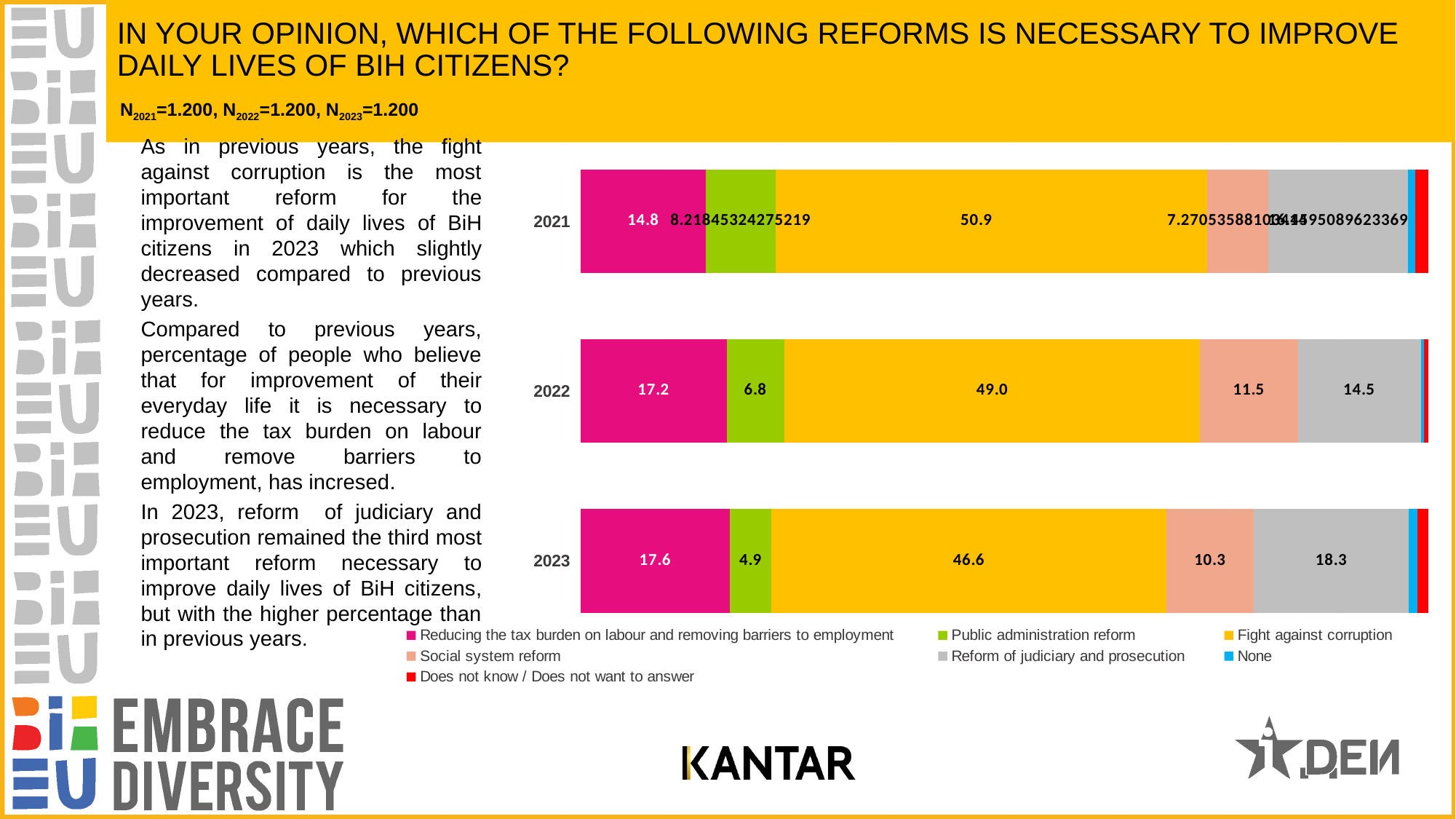
How many years are shown on the chart? 3 Does the value for Fight against corruption rise or fall from 2021 to 2023? fall In which year is the value for Fight against corruption highest? 2021 What is the value for Reform of judiciary and prosecution in 2023? 18.3 In which year is the value for Public administration reform lowest? 2023 Which year has the larger value for Reducing the tax burden on labour and removing barriers to employment, 2021 or 2023? 2023 What is the value for Fight against corruption in 2021? 50.9 What is the difference between the Fight against corruption values for 2022 and 2023? 2.4 What is the value for Fight against corruption in 2023? 46.6 What is the value for Reducing the tax burden on labour and removing barriers to employment in 2022? 17.2 How many series does the legend list? 7 What is the value for Social system reform in 2022? 11.5